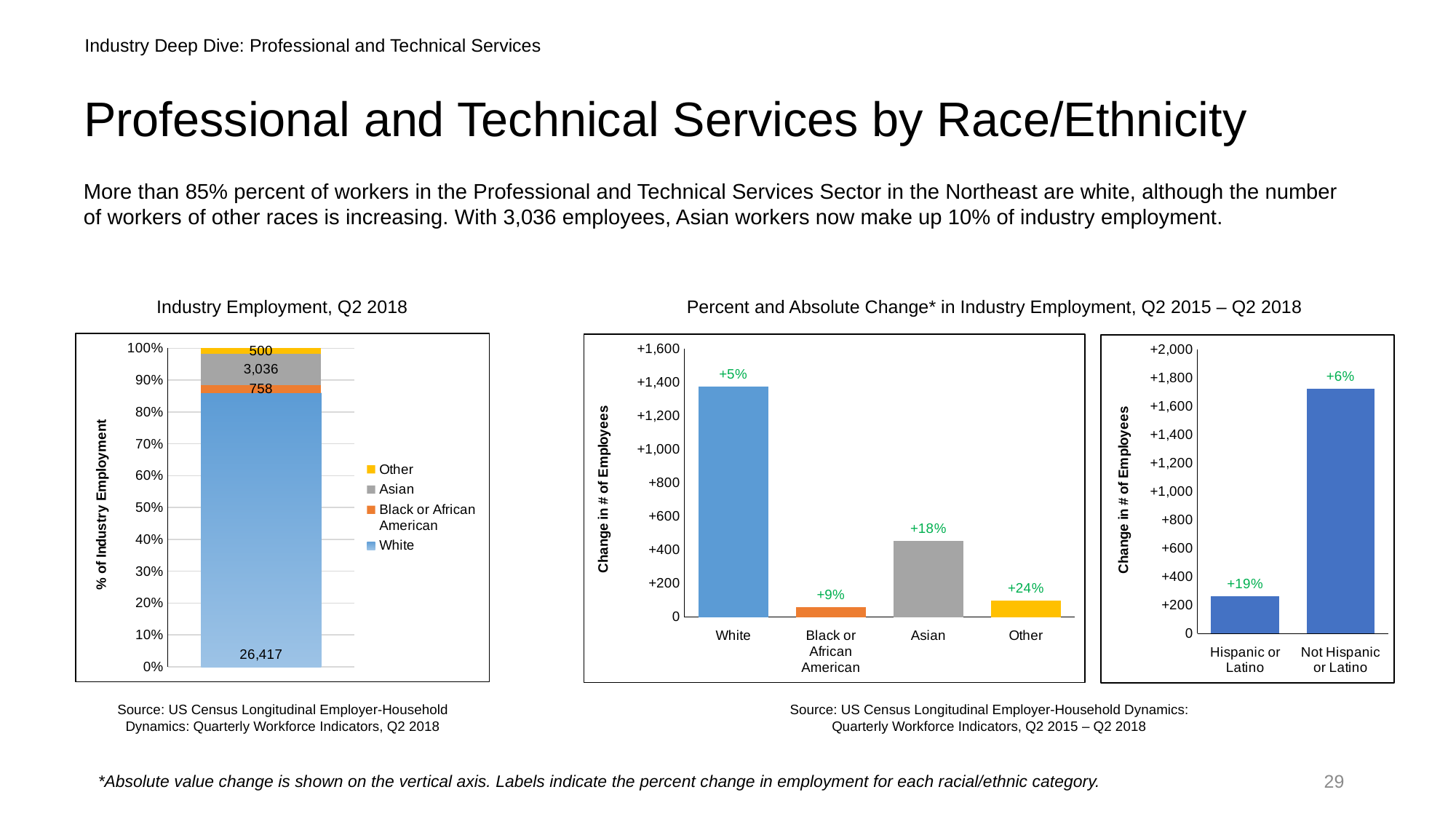
In the right chart (Hispanic or Latino vs Not Hispanic or Latino), what percent change is labelled for Hispanic or Latino? +19% In the Industry Employment, Q2 2018 chart, what is the value labelled for White? 26,417 In the Industry Employment, Q2 2018 chart, what is the value labelled for Black or African American? 758 In the middle chart (Percent and Absolute Change by race), what percent change is labelled for Asian? +18% In the Industry Employment, Q2 2018 chart, what is the value labelled for Asian? 3,036 In the middle chart (Percent and Absolute Change by race), which category has the highest percent change label? Other In the middle chart (Percent and Absolute Change by race), how many categories are shown on the x axis? 4 How many entries does the legend of the Industry Employment, Q2 2018 chart list? 4 In the Industry Employment, Q2 2018 chart, what is the total of all four labelled segments? 30,711 In the middle chart (Percent and Absolute Change by race), is the change in number of employees for White greater or less than 1,200? greater In the right chart (Hispanic or Latino vs Not Hispanic or Latino), is the change in number of employees for Not Hispanic or Latino greater or less than 1,600? greater In the Industry Employment, Q2 2018 chart, which group has the smallest labelled value? Other